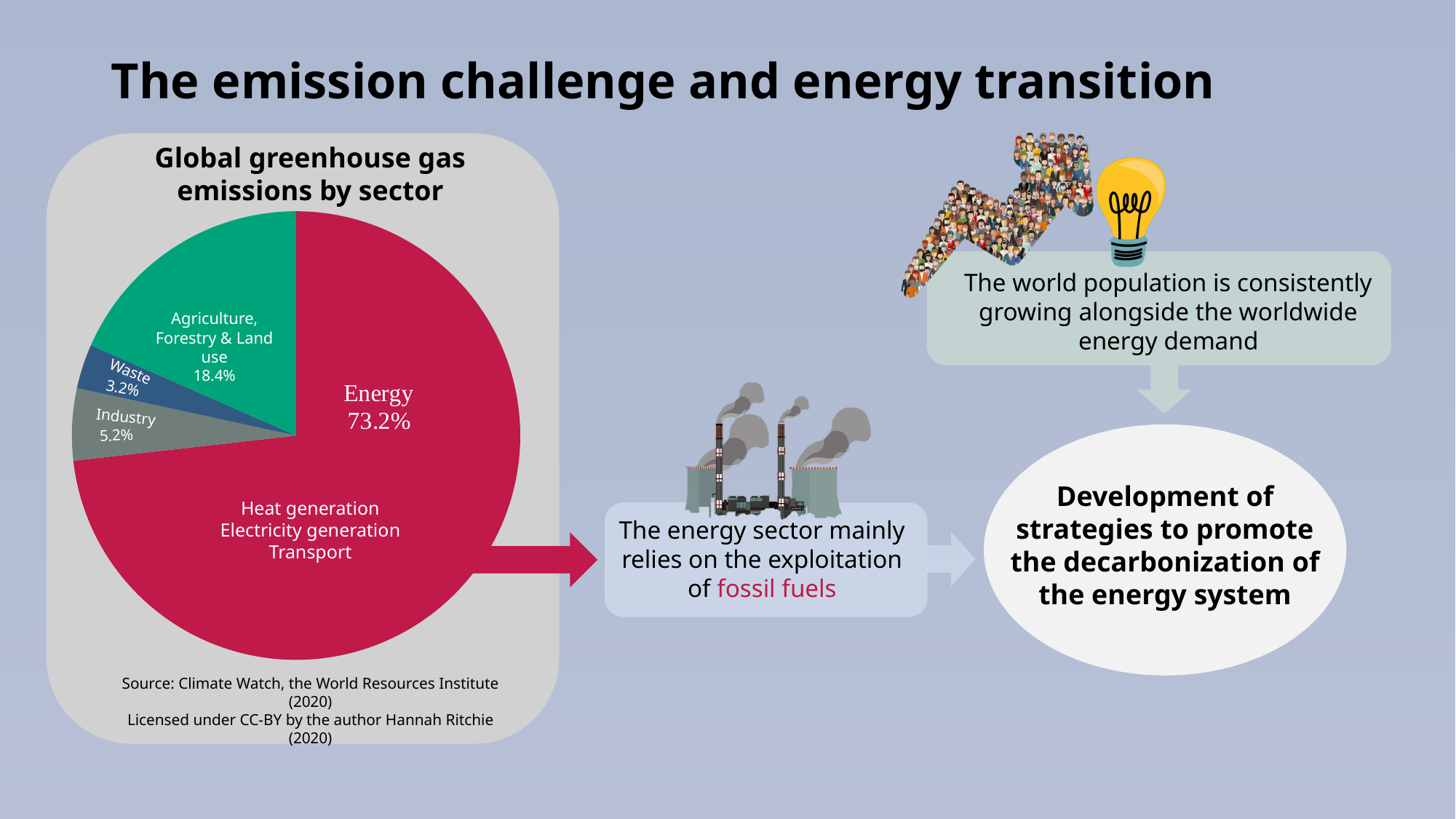
What type of chart is used to show global greenhouse gas emissions by sector? Pie chart What is the value shown for the Waste slice? 3.2% What percentage of emissions is attributed to Agriculture, Forestry & Land use? 18.4% What is the value shown for the Industry slice? 5.2% Which sector has the largest share of global greenhouse gas emissions? Energy What share of global greenhouse gas emissions does the Energy sector account for in the pie chart? 73.2% Which is larger, the Industry slice or the Waste slice? Industry Which sector has the smallest share of global greenhouse gas emissions? Waste How many percentage points larger is the Energy share than the Agriculture, Forestry & Land use share? 54.8 How many sectors are shown in the pie chart? 4 What is the title of the chart on the slide? Global greenhouse gas emissions by sector What is the difference in percentage points between the Industry and Waste slices? 2.0